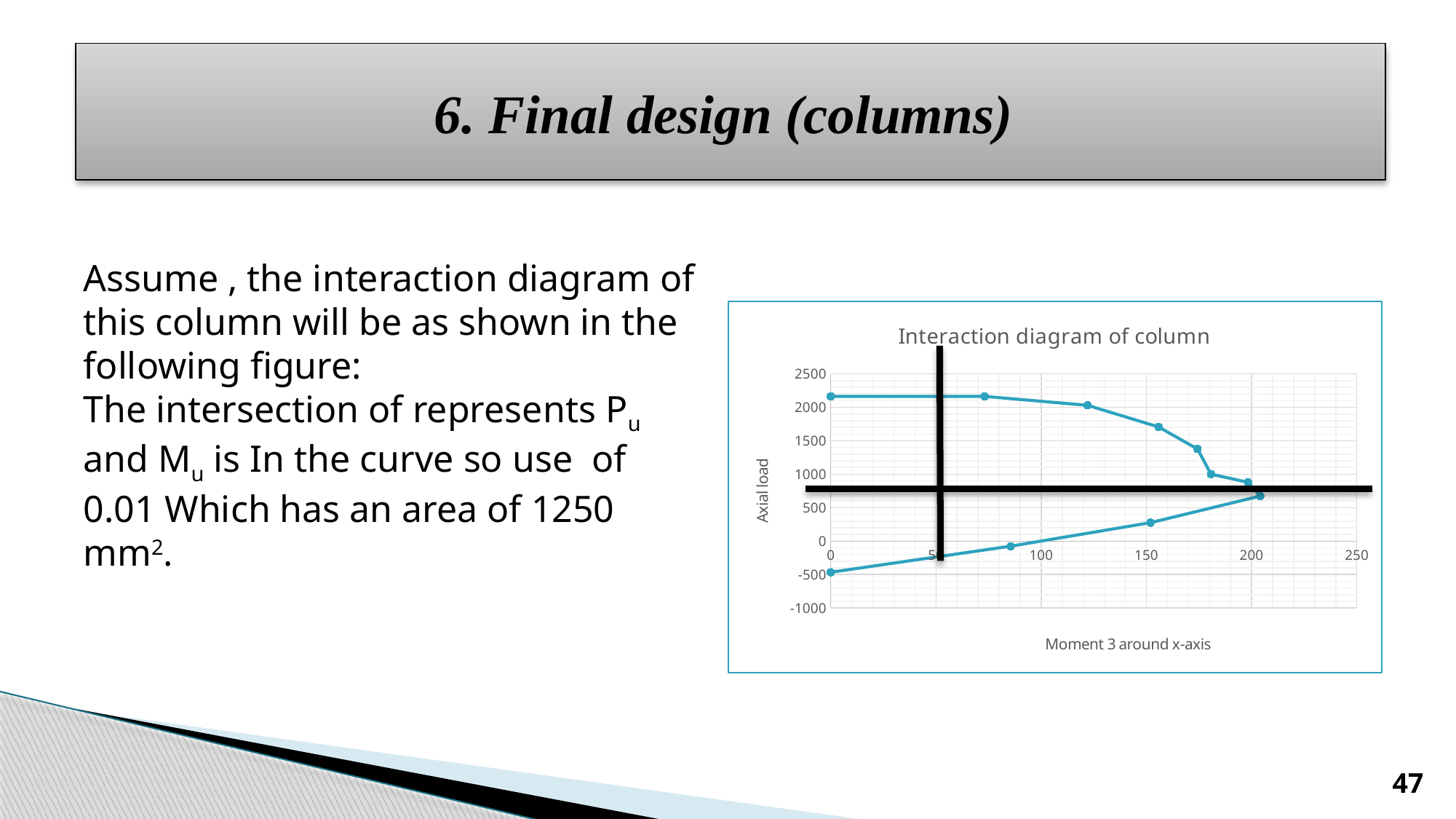
What is the label of the vertical axis of the chart? Axial load What kind of chart is shown on the slide? line chart Is the largest moment reached by the curve greater or less than 250? less Is the axial load at a moment of 0 on the upper branch of the curve greater or less than 2000? greater Is the axial load of the upper-branch point near a moment of 150 greater or less than 1500? greater What is the highest value shown on the horizontal axis? 250 How many data points are plotted on the curve? 11 At what moment value does the lowest axial load on the curve occur? 0 Along the upper branch of the curve, does the axial load rise or fall as the moment increases? fall What is the title of the chart? Interaction diagram of column